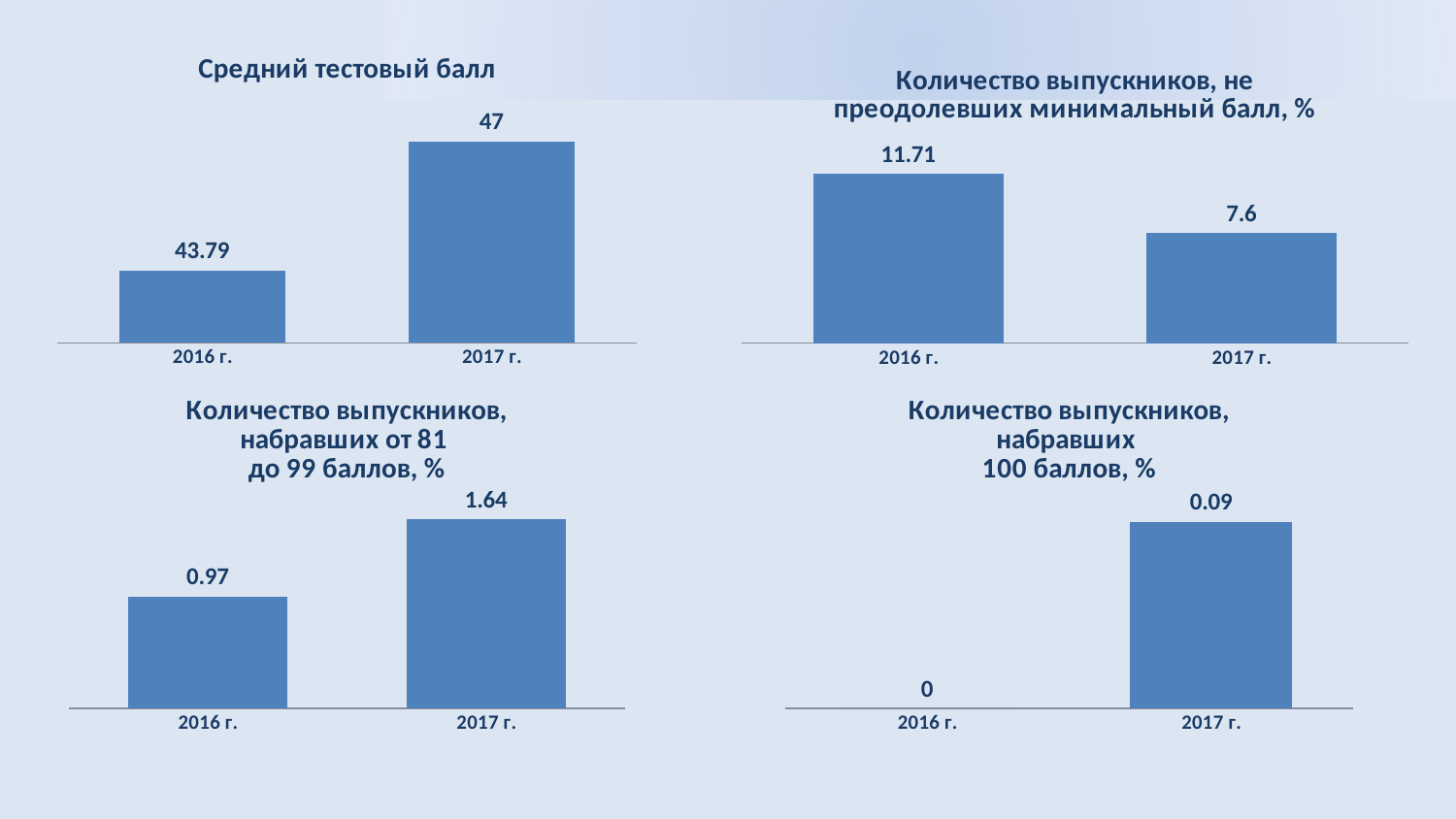
In the chart titled "Средний тестовый балл", what is the value for 2016 г.? 43.79 In the chart titled "Количество выпускников, набравших от 81 до 99 баллов, %", what is the value for 2017 г.? 1.64 In the chart titled "Средний тестовый балл", what is the difference between the 2017 г. and 2016 г. values? 3.21 In the chart titled "Количество выпускников, набравших от 81 до 99 баллов, %", what is the difference between the 2017 г. and 2016 г. values? 0.67 In the chart titled "Количество выпускников, набравших 100 баллов, %", what is the value for 2016 г.? 0 In the chart titled "Количество выпускников, не преодолевших минимальный балл, %", which year has the lowest value? 2017 г. How many categories are shown on the x axis of the chart titled "Средний тестовый балл"? 2 In the chart titled "Количество выпускников, не преодолевших минимальный балл, %", what is the value for 2016 г.? 11.71 In the chart titled "Средний тестовый балл", what is the value for 2017 г.? 47 In the chart titled "Количество выпускников, не преодолевших минимальный балл, %", do the values rise or fall from 2016 г. to 2017 г.? fall What type of chart is the chart titled "Количество выпускников, набравших 100 баллов, %"? bar chart In the chart titled "Количество выпускников, набравших 100 баллов, %", which year has the highest value? 2017 г.